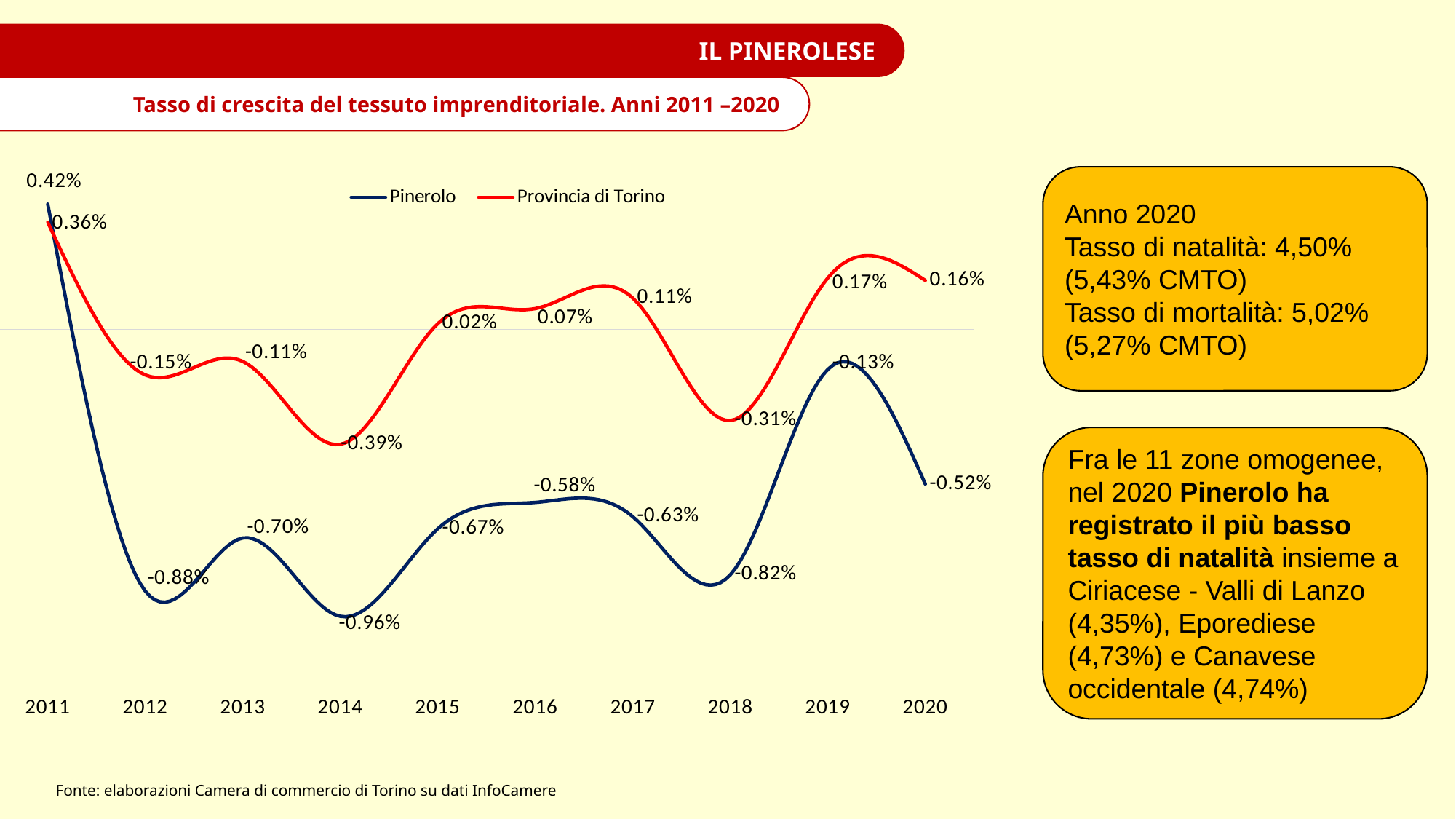
Does the Pinerolo series rise or fall from 2018 to 2019? Rise What is the value for Pinerolo in 2014? -0.96% What is the value for Provincia di Torino in 2018? -0.31% In which year does the Pinerolo series reach its lowest value? 2014 How many series does the legend list? 2 In which year does the Provincia di Torino series reach its highest value? 2011 Which series has the higher value in 2011, Pinerolo or Provincia di Torino? Pinerolo What is the value for Provincia di Torino in 2020? 0.16% What is the difference between the Provincia di Torino value and the Pinerolo value in 2020? 0.68% What kind of chart is shown on the slide? Line chart What is the value for Pinerolo in 2019? -0.13% How many years are shown on the x axis? 10